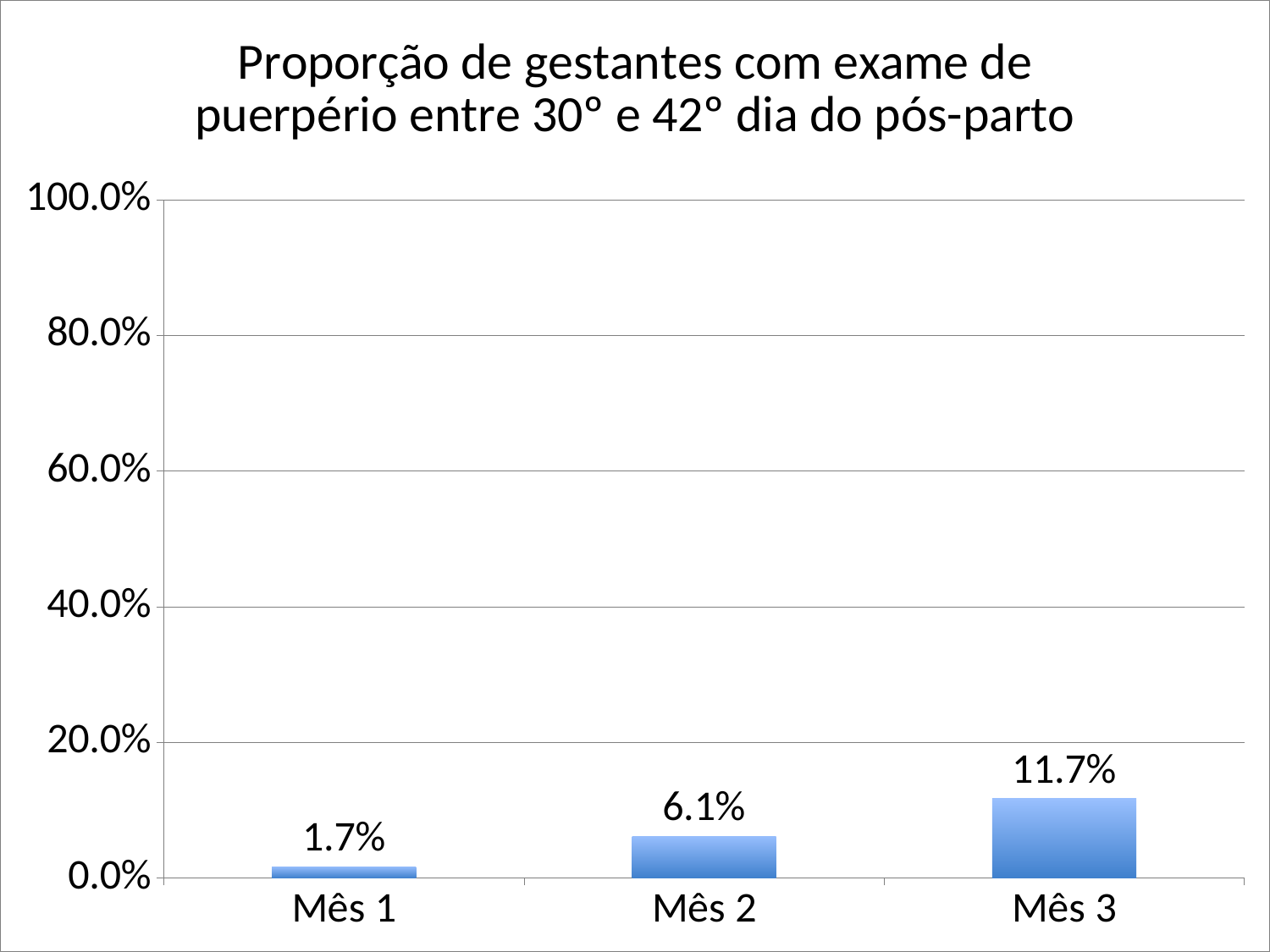
What is the value for Mês 2? 6.1% What is the value for Mês 3? 11.7% What kind of chart is this? bar chart What is the value for Mês 1? 1.7% Is the value for Mês 3 greater or less than 20.0%? less Do the values rise or fall from Mês 1 to Mês 3? rise Which is larger, the value for Mês 2 or the value for Mês 3? Mês 3 Which month has the highest value? Mês 3 How many months are shown on the x axis? 3 Which month has the lowest value? Mês 1 What is the difference between the values for Mês 3 and Mês 1? 10.0% What is the difference between the values for Mês 2 and Mês 1? 4.4%